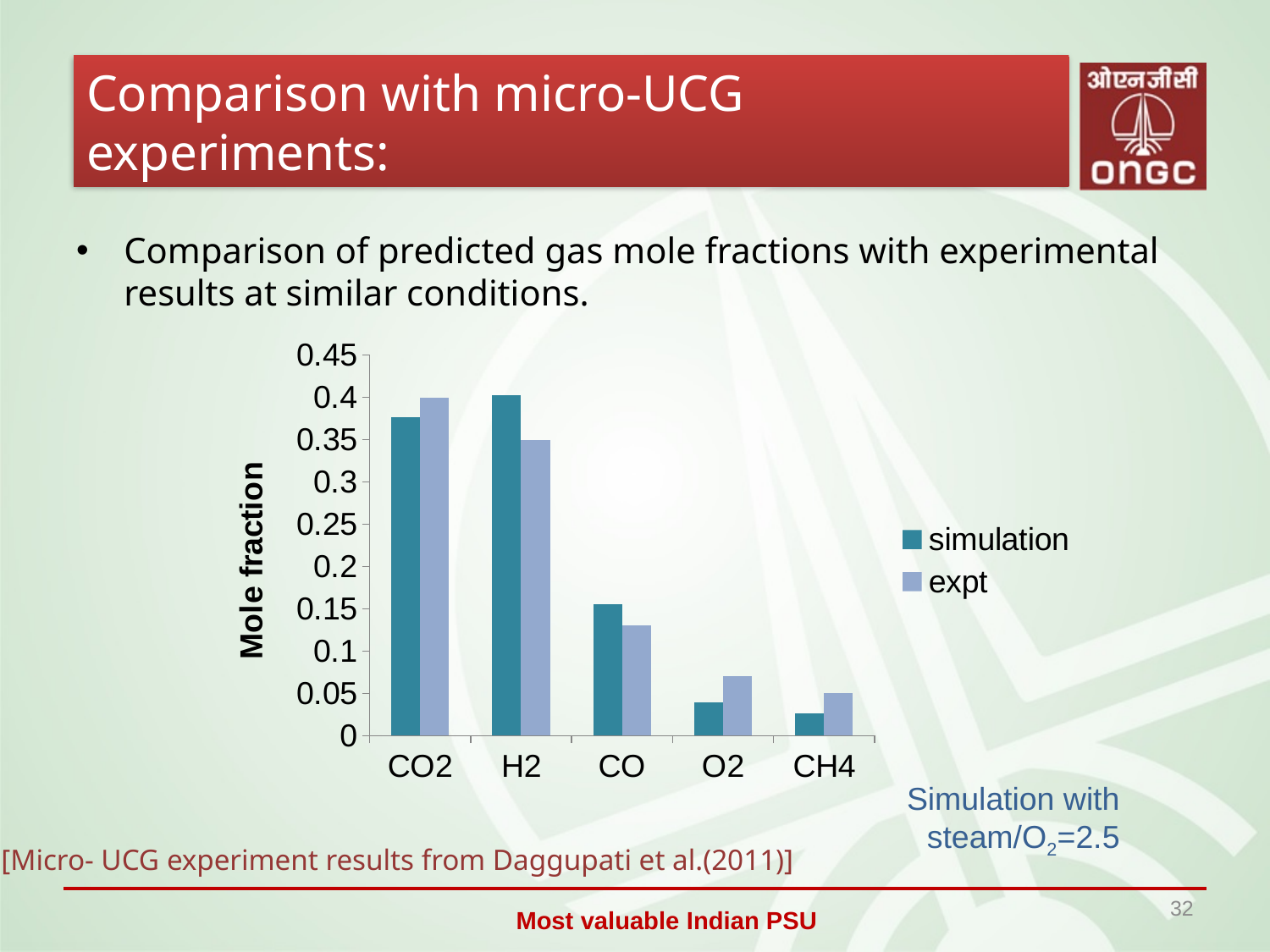
Is the simulation value for CO greater or less than 0.1? greater Which gas has the lowest simulation mole fraction? CH4 For H2, which is larger, the simulation value or the expt value? simulation How many series does the chart legend list? 2 Is the expt value for O2 greater or less than 0.1? less What is the label of the vertical axis of the chart? Mole fraction How many gas categories are shown on the x axis of the chart? 5 What kind of chart is shown on the slide? bar chart For O2, which is larger, the simulation value or the expt value? expt What are the two series named in the chart legend? simulation and expt Which gas has the highest simulation mole fraction? H2 Which gas has the highest expt mole fraction? CO2